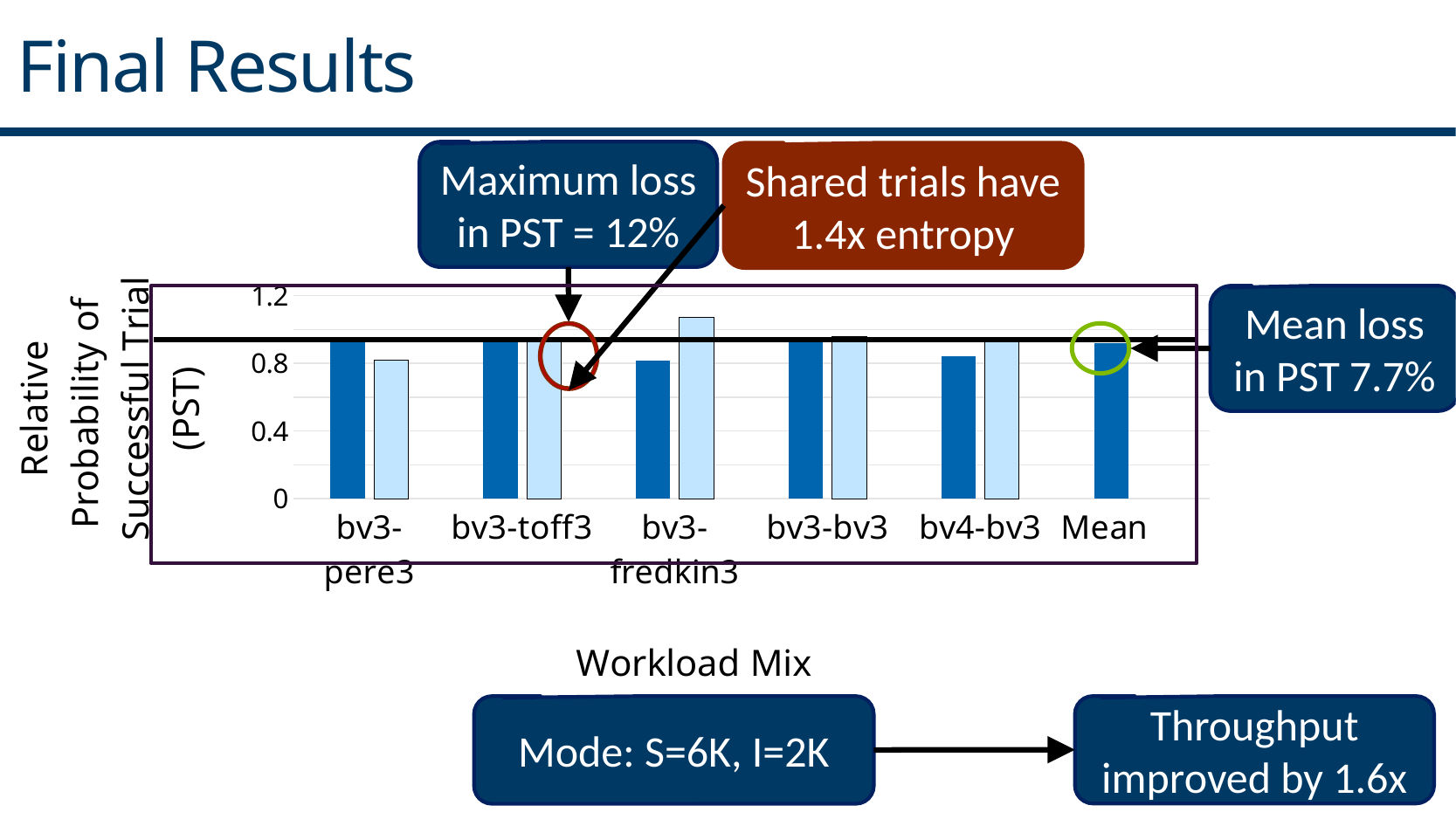
What is the title of the x axis of the chart? Workload Mix Is the light-blue bar for bv3-fredkin3 greater or less than 1.2? less Which category has the tallest light-blue bar in the chart? bv3-fredkin3 For bv3-fredkin3, which bar is taller, the dark-blue bar or the light-blue bar? the light-blue bar Is the dark-blue bar for Mean greater or less than 1.2? less Is the dark-blue bar for bv3-toff3 greater or less than 0.8? greater What is the label on the y axis of the chart? Relative Probability of Successful Trial (PST) How many workload mix categories are shown on the x axis of the chart? 6 What kind of chart is shown on the slide? bar chart What is the highest value shown on the y axis of the chart? 1.2